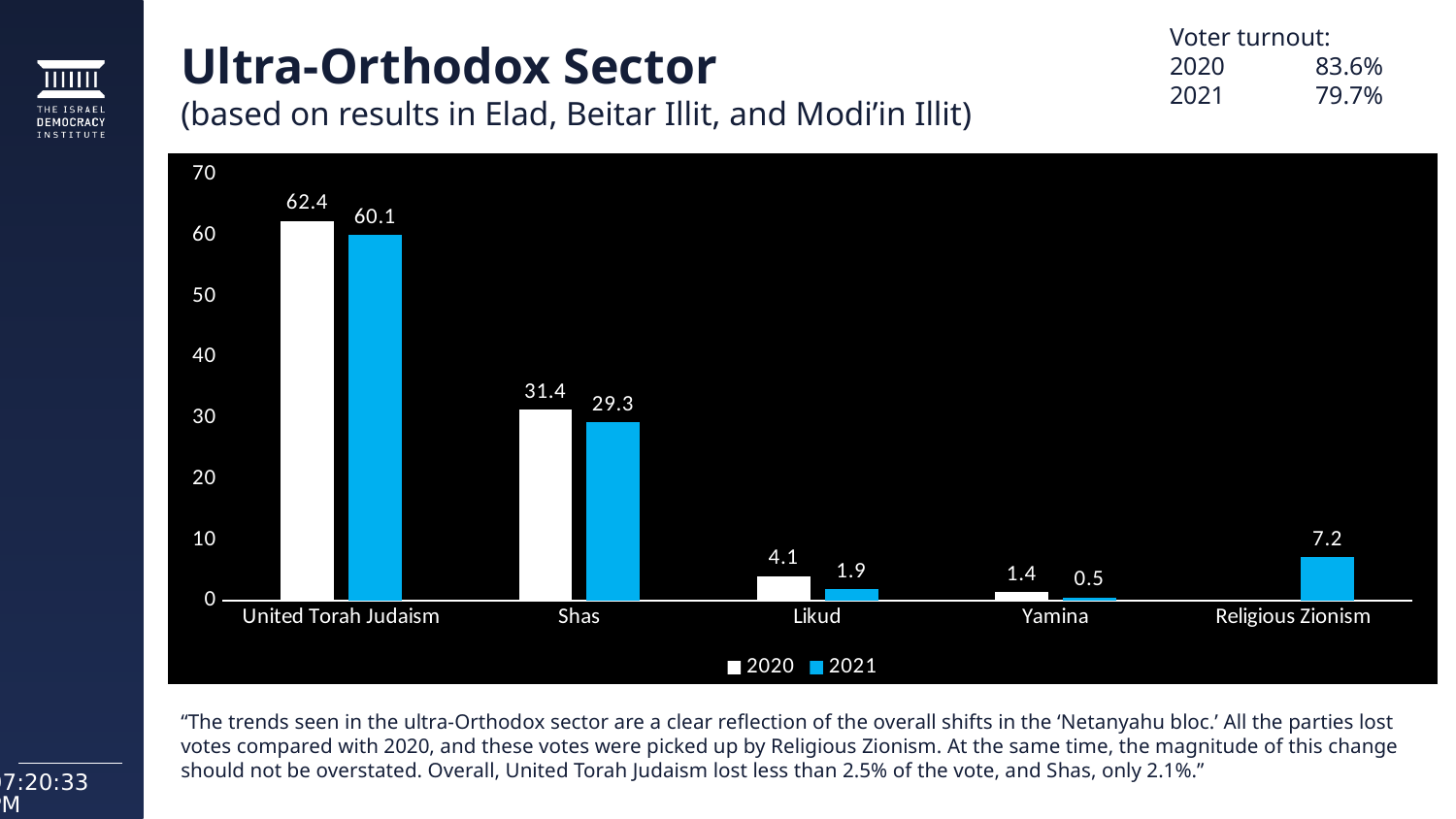
Which party has the lowest 2021 value? Yamina What is the difference between the 2020 and 2021 values for United Torah Judaism? 2.3 Which is larger: the 2021 value for Likud or the 2021 value for Religious Zionism? Religious Zionism How many series does the legend list? 2 What is the difference between the 2020 and 2021 values for Shas? 2.1 What kind of chart is shown on the slide? Bar chart What is the 2020 value for Likud? 4.1 Which party has the highest 2021 value? United Torah Judaism What is the 2020 value for United Torah Judaism? 62.4 What is the 2021 value for Shas? 29.3 How many parties are shown on the x axis? 5 What is the 2021 value for Religious Zionism? 7.2